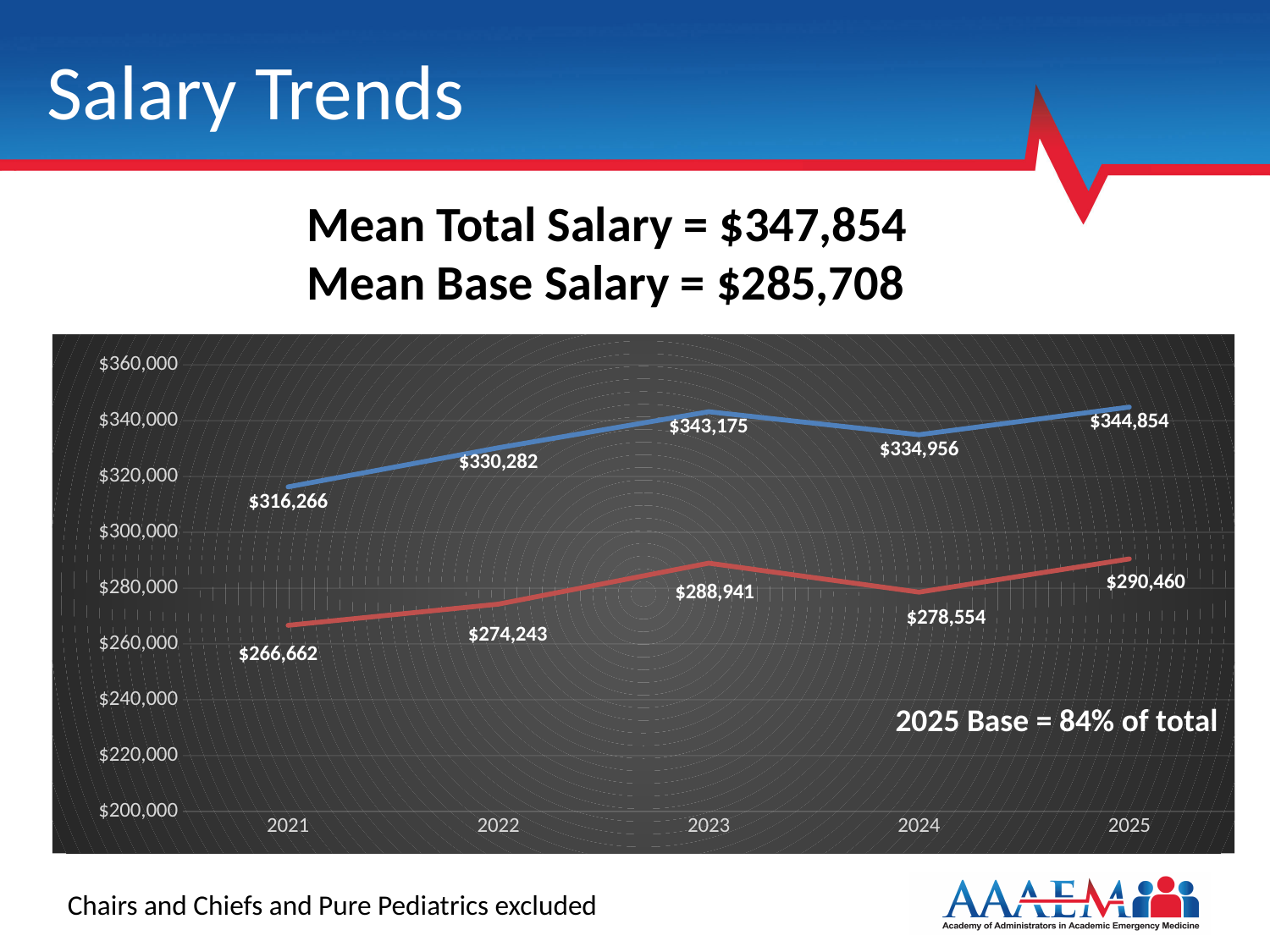
What is the difference between the blue line and the red line in 2025? $54,394 Does the blue line rise or fall from 2021 to 2023? Rise How many years are plotted along the x axis of the chart? 5 Is the value of the red line in 2021 greater or less than $280,000? less By how much did the blue line increase from 2021 to 2025? $28,588 In which year does the blue line reach its highest value? 2025 What is the value of the red line in 2024? $278,554 What is the value of the blue line in 2023? $343,175 In which year does the red line reach its lowest value? 2021 What is the value of the blue line in 2021? $316,266 What type of chart is shown on the slide? Line chart Which is larger, the red line's value in 2023 or in 2024? 2023